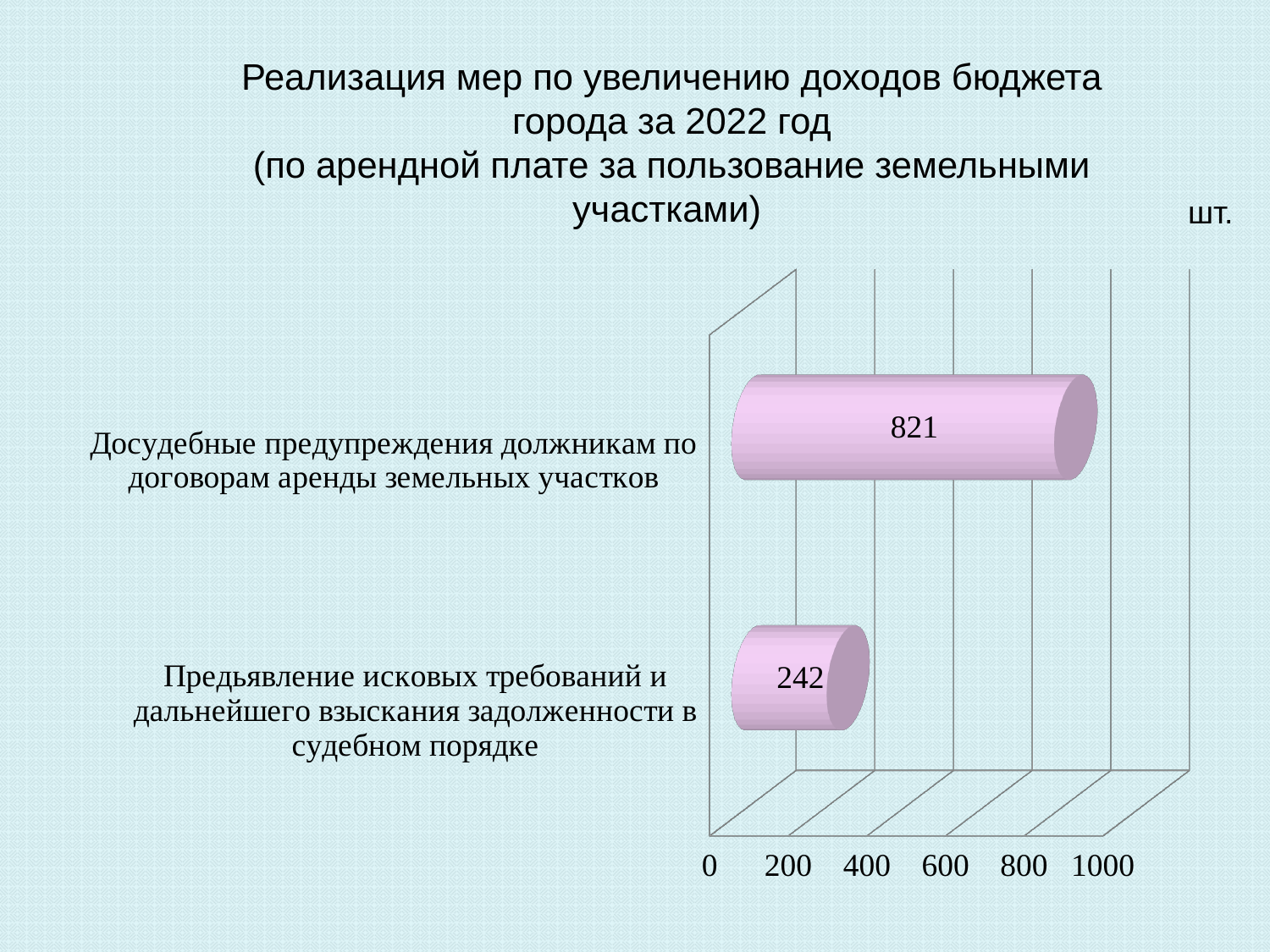
Which category has the lowest value? Предъявление исковых требований и дальнейшего взыскания задолженности в судебном порядке What unit is indicated for the chart values? шт. What kind of chart is shown on the slide? bar chart Which category has the highest value? Досудебные предупреждения должникам по договорам аренды земельных участков How many categories are shown in the chart? 2 What is the value for "Предъявление исковых требований и дальнейшего взыскания задолженности в судебном порядке"? 242 What is the maximum value shown on the horizontal axis? 1000 Which is larger: the value for "Досудебные предупреждения должникам по договорам аренды земельных участков" or the value for "Предъявление исковых требований и дальнейшего взыскания задолженности в судебном порядке"? Досудебные предупреждения должникам по договорам аренды земельных участков Is the value for "Досудебные предупреждения должникам по договорам аренды земельных участков" greater or less than 600? greater What is the value for "Досудебные предупреждения должникам по договорам аренды земельных участков"? 821 What is the difference between the value for "Досудебные предупреждения должникам по договорам аренды земельных участков" and the value for "Предъявление исковых требований и дальнейшего взыскания задолженности в судебном порядке"? 579 Is the value for "Предъявление исковых требований и дальнейшего взыскания задолженности в судебном порядке" greater or less than 400? less